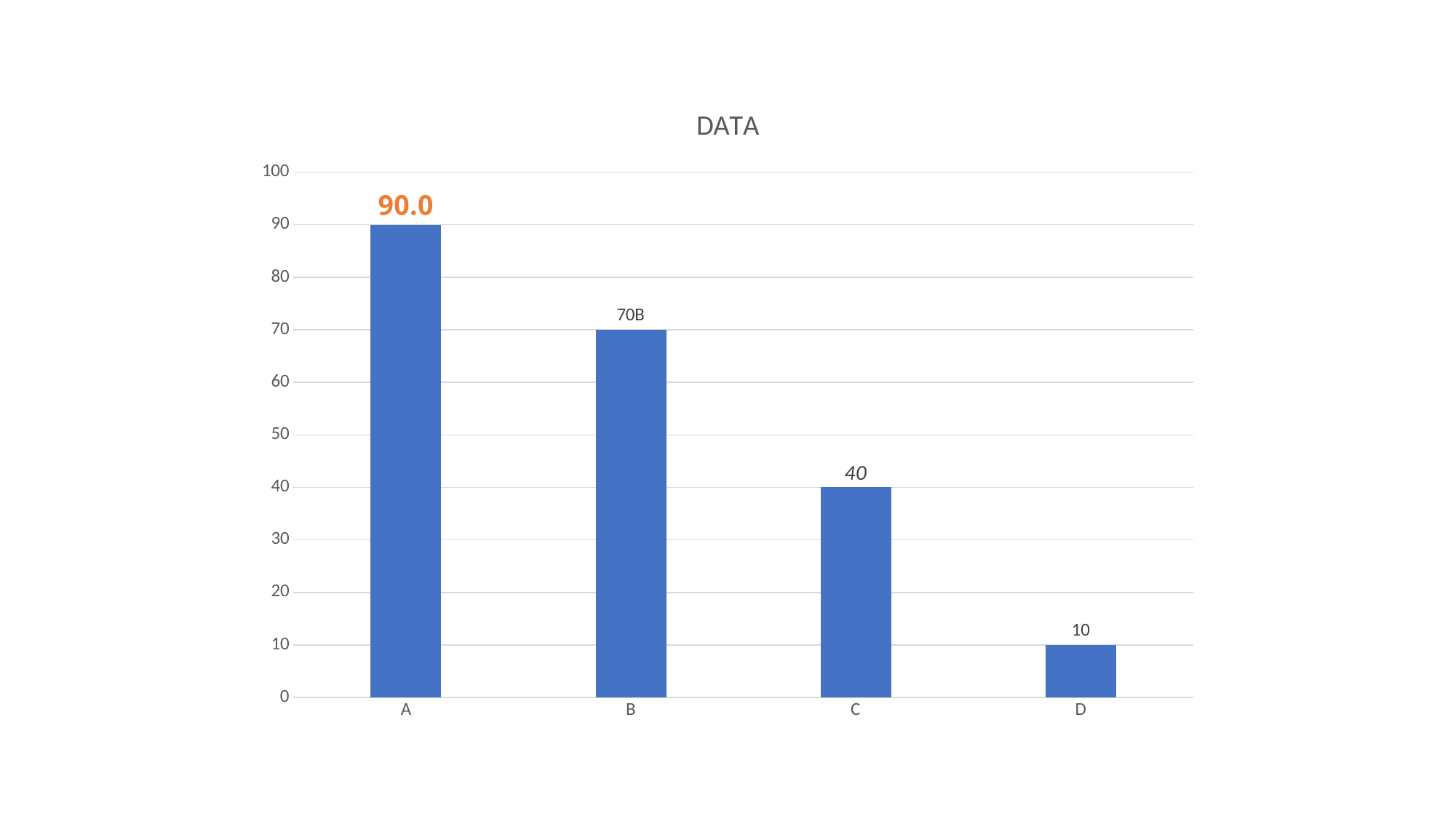
Which has the larger value, B or C? B What data label is shown above the bar for category B? 70B Which category has the lowest value? D What is the title of the chart? DATA What is the value shown for category C? 40 Is the value for C greater or less than 50? less How many categories are shown on the x axis? 4 What is the value shown for category D? 10 What is the value shown for category A? 90.0 Which category has the highest value? A What kind of chart is shown on the slide? bar chart What is the difference between the values for C and D? 30